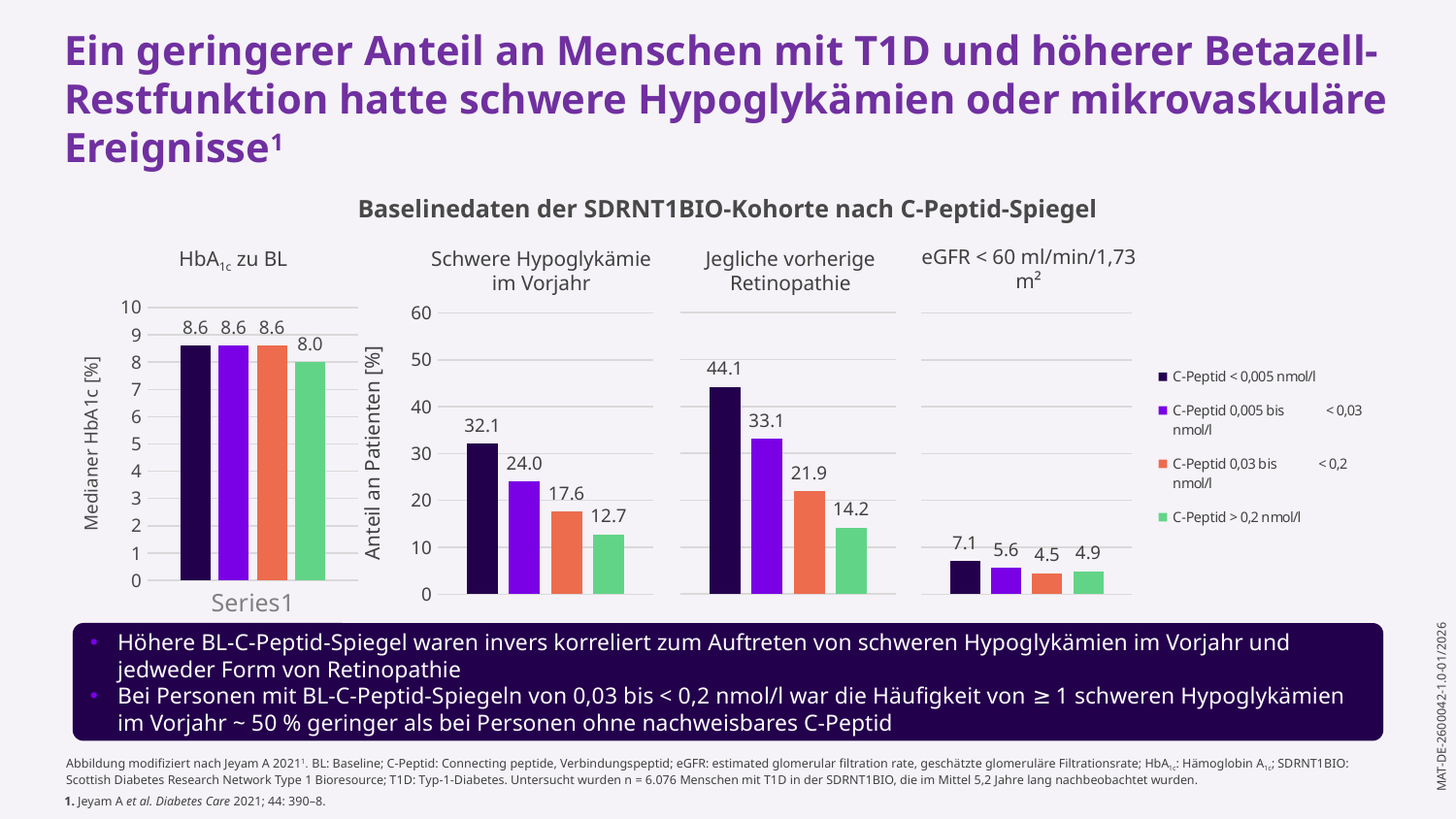
In the left-hand 'HbA1c zu BL' chart, what is the value for C-Peptid > 0,2 nmol/l? 8.0 In the 'eGFR < 60 ml/min/1,73 m²' group of the right-hand chart, which is larger: the value for C-Peptid 0,03 bis < 0,2 nmol/l or for C-Peptid > 0,2 nmol/l? C-Peptid > 0,2 nmol/l In the 'Schwere Hypoglykämie im Vorjahr' group of the right-hand chart, is the value for C-Peptid 0,005 bis < 0,03 nmol/l greater or less than 20? greater In the 'Jegliche vorherige Retinopathie' group of the right-hand chart, what is the value for C-Peptid > 0,2 nmol/l? 14.2 In the 'Schwere Hypoglykämie im Vorjahr' group of the right-hand chart, do the values rise or fall as the C-Peptid level increases from left to right? Fall In the 'eGFR < 60 ml/min/1,73 m²' group of the right-hand chart, what is the value for C-Peptid 0,03 bis < 0,2 nmol/l? 4.5 How many series does the legend of the right-hand chart list? 4 What kind of chart is the right-hand chart? Bar chart In the 'Jegliche vorherige Retinopathie' group of the right-hand chart, which C-Peptid category has the highest value? C-Peptid < 0,005 nmol/l In the 'Schwere Hypoglykämie im Vorjahr' group of the right-hand chart, which C-Peptid category has the lowest value? C-Peptid > 0,2 nmol/l In the 'Schwere Hypoglykämie im Vorjahr' group of the right-hand chart, what is the value for C-Peptid < 0,005 nmol/l? 32.1 In the right-hand chart, what is the difference between the C-Peptid < 0,005 nmol/l values for 'Jegliche vorherige Retinopathie' and 'Schwere Hypoglykämie im Vorjahr'? 12.0